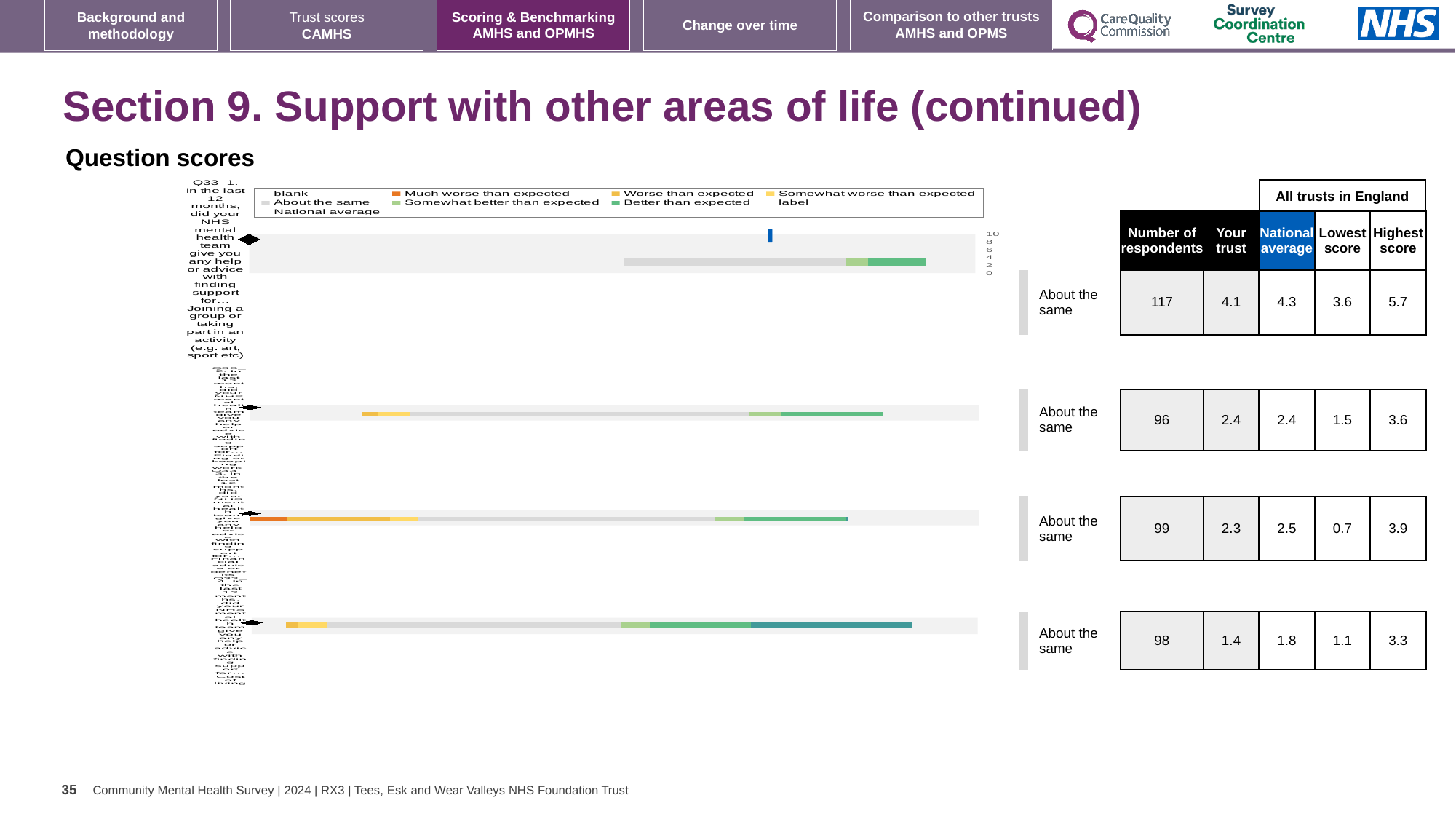
What is the 'Your trust' score for the fourth (bottom) row? 1.4 How many respondents are listed for the first row (Q33_1)? 117 What is the national average for the first row (Q33_1)? 4.3 How many entries does the chart legend list? 9 What is the difference between the national average and the 'Your trust' score for the fourth (bottom) row? 0.4 What benchmark label is shown next to each of the four bars? About the same What is the 'Your trust' score for the first row (Q33_1, joining a group or taking part in an activity)? 4.1 How many horizontal bars are plotted in the chart? 4 What colour is the 'Much worse than expected' legend entry? orange What kind of chart is shown under 'Question scores'? bar chart What is the highest score across all trusts in England for the first row (Q33_1)? 5.7 Which row has the lowest 'Lowest score' value in the table? the third row (0.7)